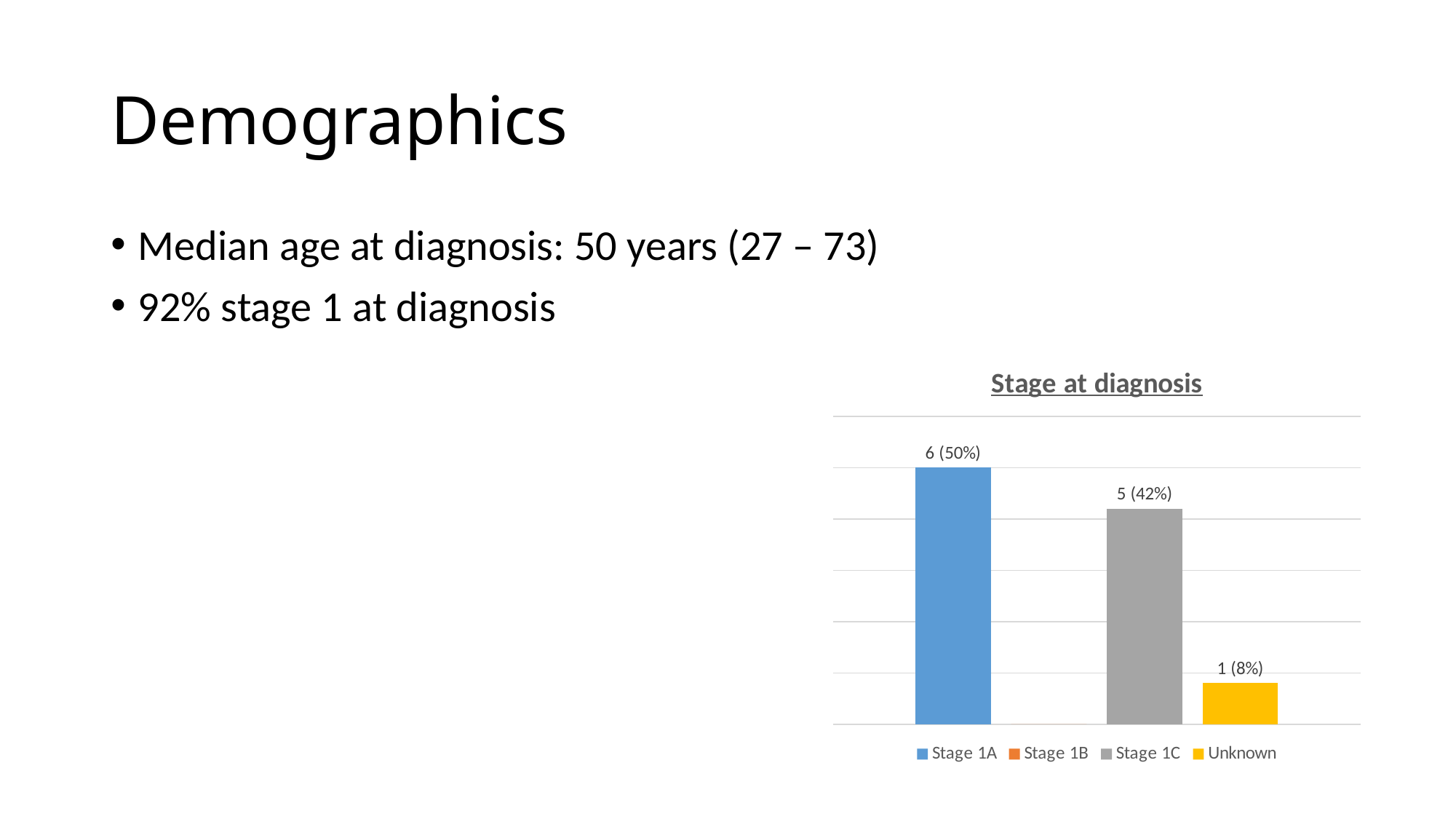
How many entries does the legend of the 'Stage at diagnosis' chart list? 4 In the 'Stage at diagnosis' chart, which category has the tallest bar? Stage 1A In the 'Stage at diagnosis' chart, how many more patients are in Stage 1A than in Stage 1C? 1 In the 'Stage at diagnosis' chart, what is the data label for Unknown? 1 (8%) What percentage of patients does the Stage 1A bar represent in the 'Stage at diagnosis' chart? 50% What kind of chart is shown on the slide? Bar chart In the 'Stage at diagnosis' chart, which is larger, Stage 1C or Unknown? Stage 1C What is the title of the chart on the slide? Stage at diagnosis In the 'Stage at diagnosis' chart, what is the difference in count between Stage 1A and Unknown? 5 In the 'Stage at diagnosis' chart, what is the data label for Stage 1A? 6 (50%) In the 'Stage at diagnosis' chart, what is the data label for Stage 1C? 5 (42%) In the 'Stage at diagnosis' chart, which of the labelled bars is the lowest? Unknown